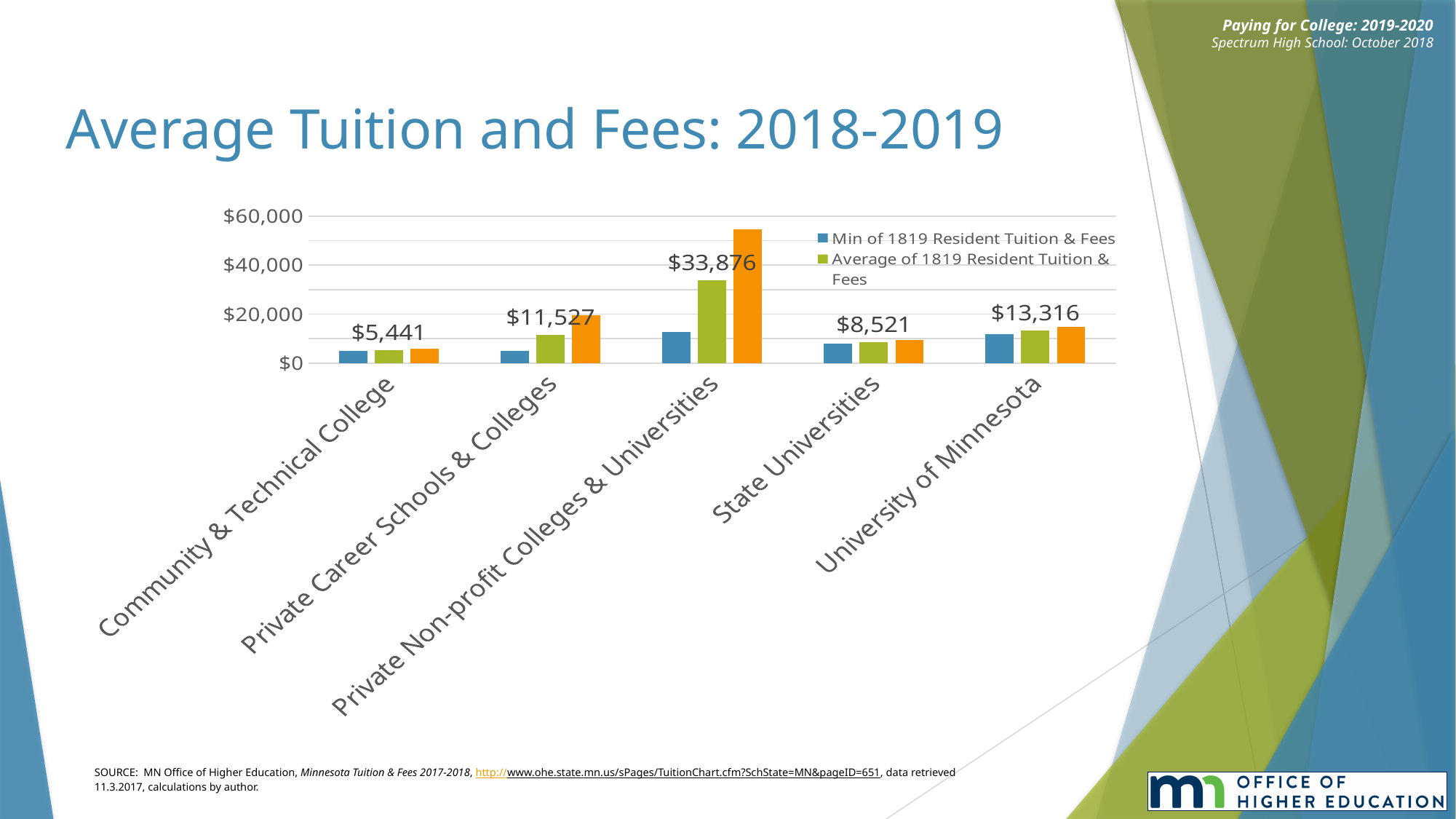
Is the tallest (orange) bar for Private Non-profit Colleges & Universities greater or less than $40,000? greater What is the average 2018-19 resident tuition and fees for Community & Technical College? $5,441 What is the average 2018-19 resident tuition and fees for Private Career Schools & Colleges? $11,527 Which category has the lowest average resident tuition and fees? Community & Technical College How much higher is the average tuition and fees for University of Minnesota than for State Universities? $4,795 What kind of chart is shown on the slide? Bar chart How many categories of institutions are shown on the x axis? 5 What is the average 2018-19 resident tuition and fees for University of Minnesota? $13,316 What is the average 2018-19 resident tuition and fees for Private Non-profit Colleges & Universities? $33,876 What is the average 2018-19 resident tuition and fees for State Universities? $8,521 Which has the larger average tuition and fees: Private Career Schools & Colleges or University of Minnesota? University of Minnesota Which category has the highest average resident tuition and fees? Private Non-profit Colleges & Universities